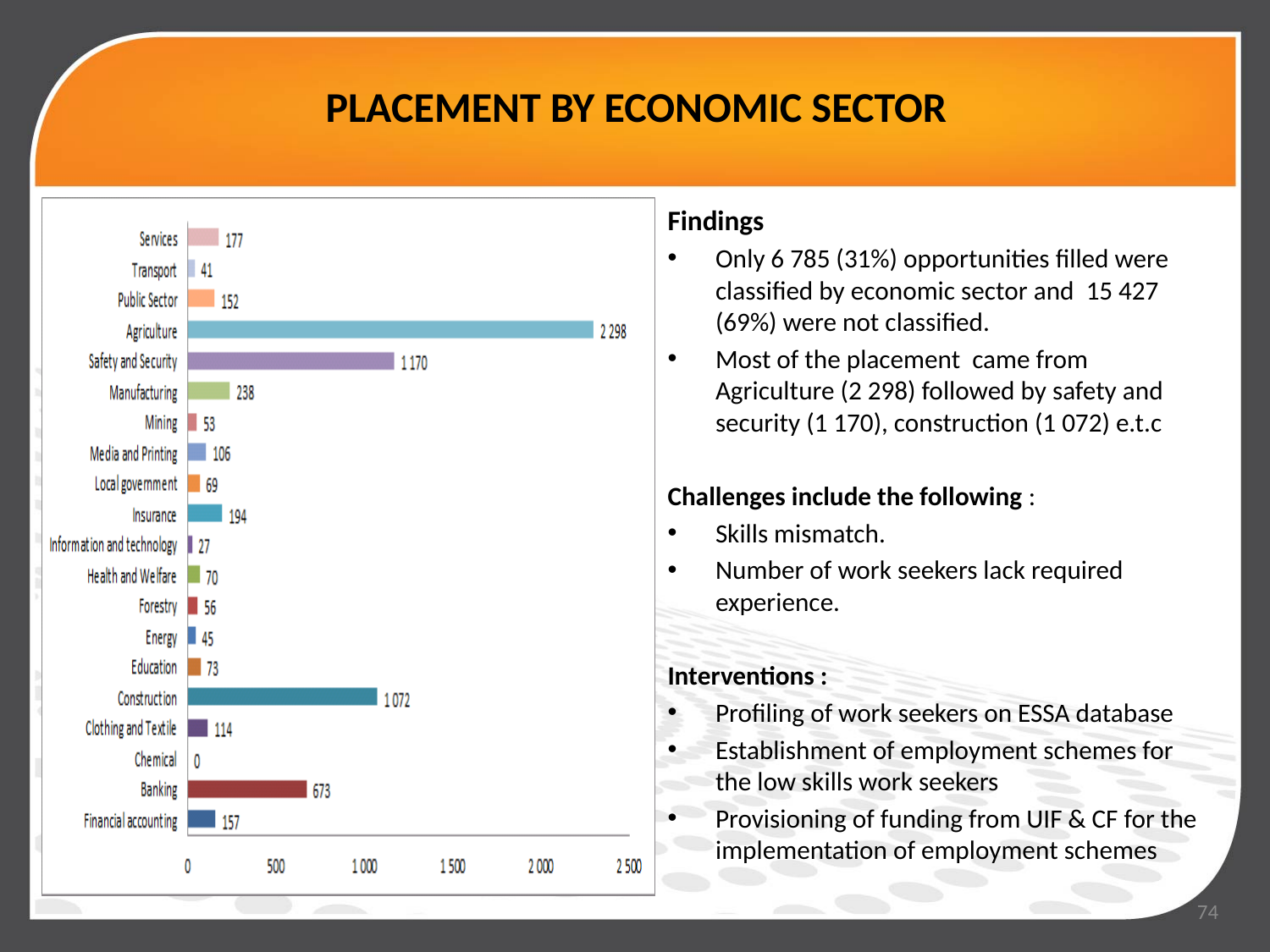
What is the value for Banking? 673 What is the value for Agriculture? 2 298 Which sector has the highest value? Agriculture What is the difference between the values for Construction and Banking? 399 Which is larger, the value for Insurance or the value for Services? Insurance Which sector has the lowest value? Chemical What kind of chart is shown on the slide? bar chart What is the value for Construction? 1 072 How many sectors are shown in the chart? 20 What is the difference between the values for Agriculture and Safety and Security? 1 128 Is the value for Banking greater or less than 500? greater What is the value for Media and Printing? 106